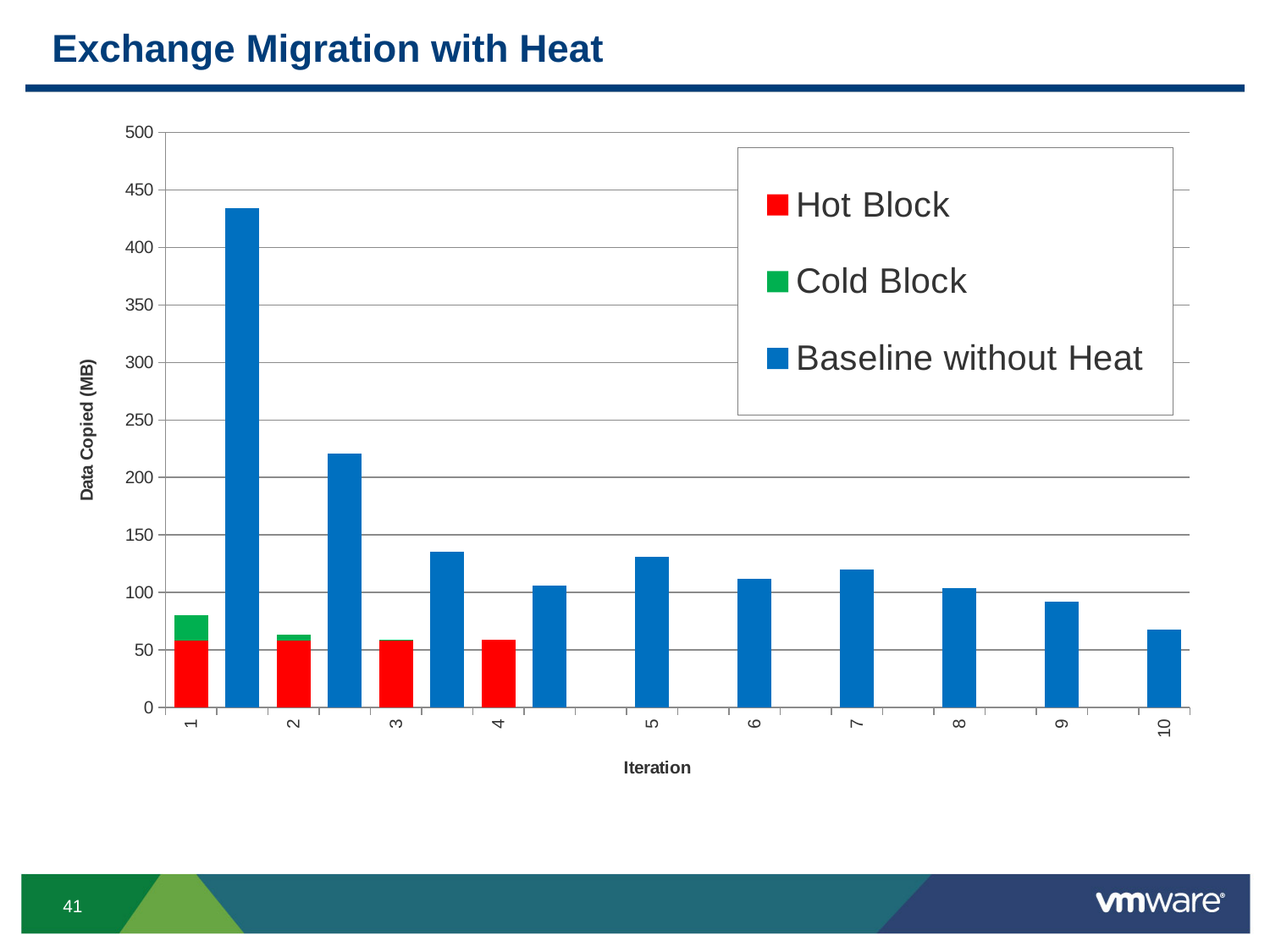
At which iteration is the Baseline without Heat value highest? 1 How many series does the legend list? 3 Is the Baseline without Heat value for iteration 2 greater or less than 200? greater At which iteration is the Baseline without Heat value lowest? 10 Which has the larger Baseline without Heat value, iteration 2 or iteration 3? Iteration 2 Does the Baseline without Heat value rise or fall from iteration 1 to iteration 4? Fall How many iterations are shown on the x axis? 10 Is the Baseline without Heat value for iteration 10 greater or less than 100? less Is the Baseline without Heat value for iteration 1 greater or less than 400? greater What is the title of the y axis? Data Copied (MB) What kind of chart is shown on the slide? Bar chart Which has the larger Baseline without Heat value, iteration 9 or iteration 10? Iteration 9